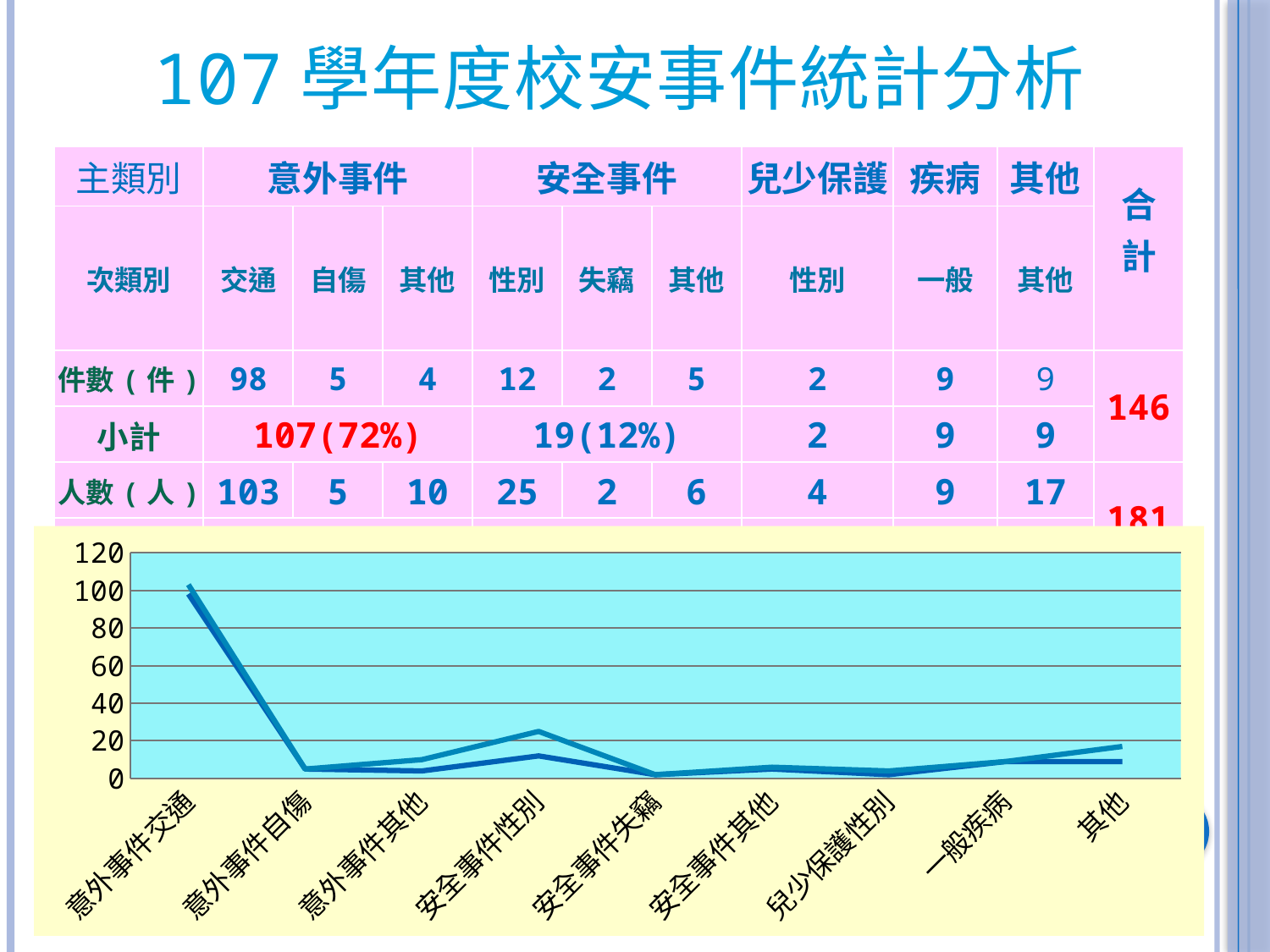
In the line chart, do the values rise or fall from 意外事件交通 to 意外事件自傷? fall How many categories are shown along the x axis of the line chart? 9 In the line chart, is the value for 意外事件自傷 greater or less than 20? less In the line chart, is the value for 意外事件交通 greater or less than 80? greater In the line chart, which is larger: the value for 安全事件性別 or the value for 安全事件失竊? 安全事件性別 Which category has the highest value in the line chart? 意外事件交通 In the line chart, is the value for 安全事件性別 greater or less than 40? less In the line chart, which is larger: the value for 意外事件交通 or the value for 安全事件性別? 意外事件交通 How many lines are plotted in the line chart? 2 What is the highest tick value shown on the y axis of the line chart? 120 What kind of chart is shown at the bottom of the slide? line chart